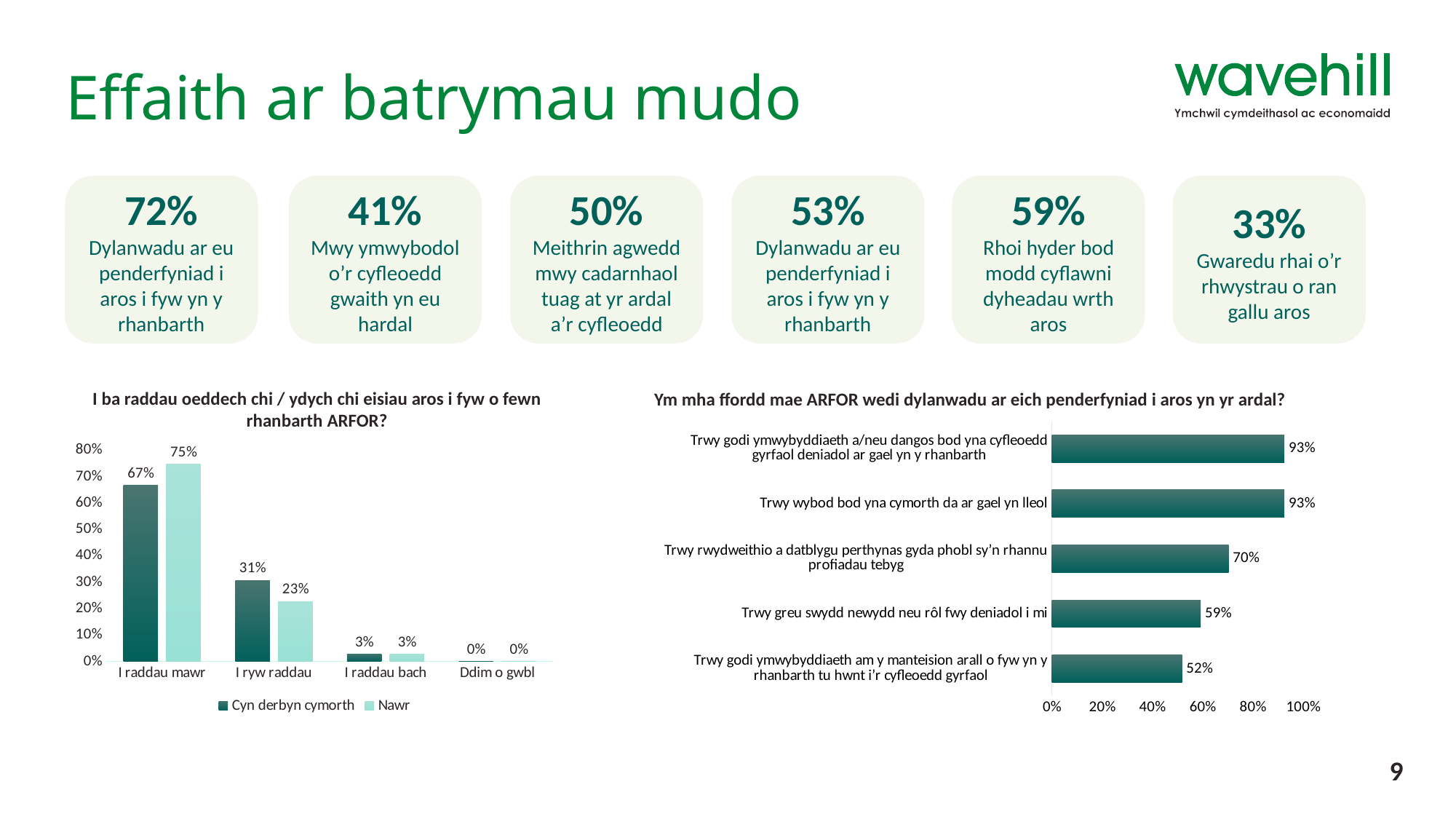
In the left chart 'I ba raddau oeddech chi / ydych chi eisiau aros i fyw o fewn rhanbarth ARFOR?', which category has the lowest values? Ddim o gwbl How many series does the legend of the left chart 'I ba raddau oeddech chi / ydych chi eisiau aros i fyw o fewn rhanbarth ARFOR?' list? 2 In the left chart 'I ba raddau oeddech chi / ydych chi eisiau aros i fyw o fewn rhanbarth ARFOR?', what is the value for 'I raddau mawr' in the 'Nawr' series? 75% In the right chart 'Ym mha ffordd mae ARFOR wedi dylanwadu ar eich penderfyniad i aros yn yr ardal?', what is the difference between the values for 'Trwy wybod bod yna cymorth da ar gael yn lleol' and 'Trwy greu swydd newydd neu rôl fwy deniadol i mi'? 34% How many categories are shown on the x axis of the left chart 'I ba raddau oeddech chi / ydych chi eisiau aros i fyw o fewn rhanbarth ARFOR?'? 4 In the left chart 'I ba raddau oeddech chi / ydych chi eisiau aros i fyw o fewn rhanbarth ARFOR?', what is the value for 'I ryw raddau' in the 'Cyn derbyn cymorth' series? 31% In the left chart 'I ba raddau oeddech chi / ydych chi eisiau aros i fyw o fewn rhanbarth ARFOR?', what is the difference between the 'Nawr' and 'Cyn derbyn cymorth' values for 'I raddau mawr'? 8% In the left chart 'I ba raddau oeddech chi / ydych chi eisiau aros i fyw o fewn rhanbarth ARFOR?', which is larger for 'I ryw raddau': 'Cyn derbyn cymorth' or 'Nawr'? Cyn derbyn cymorth What kind of chart is the right chart 'Ym mha ffordd mae ARFOR wedi dylanwadu ar eich penderfyniad i aros yn yr ardal?'? Bar chart In the right chart 'Ym mha ffordd mae ARFOR wedi dylanwadu ar eich penderfyniad i aros yn yr ardal?', which category has the lowest value? Trwy godi ymwybyddiaeth am y manteision arall o fyw yn y rhanbarth tu hwnt i'r cyfleoedd gyrfaol In the right chart 'Ym mha ffordd mae ARFOR wedi dylanwadu ar eich penderfyniad i aros yn yr ardal?', what is the value for 'Trwy rwydweithio a datblygu perthynas gyda phobl sy'n rhannu profiadau tebyg'? 70% In the right chart 'Ym mha ffordd mae ARFOR wedi dylanwadu ar eich penderfyniad i aros yn yr ardal?', what is the value for 'Trwy greu swydd newydd neu rôl fwy deniadol i mi'? 59%